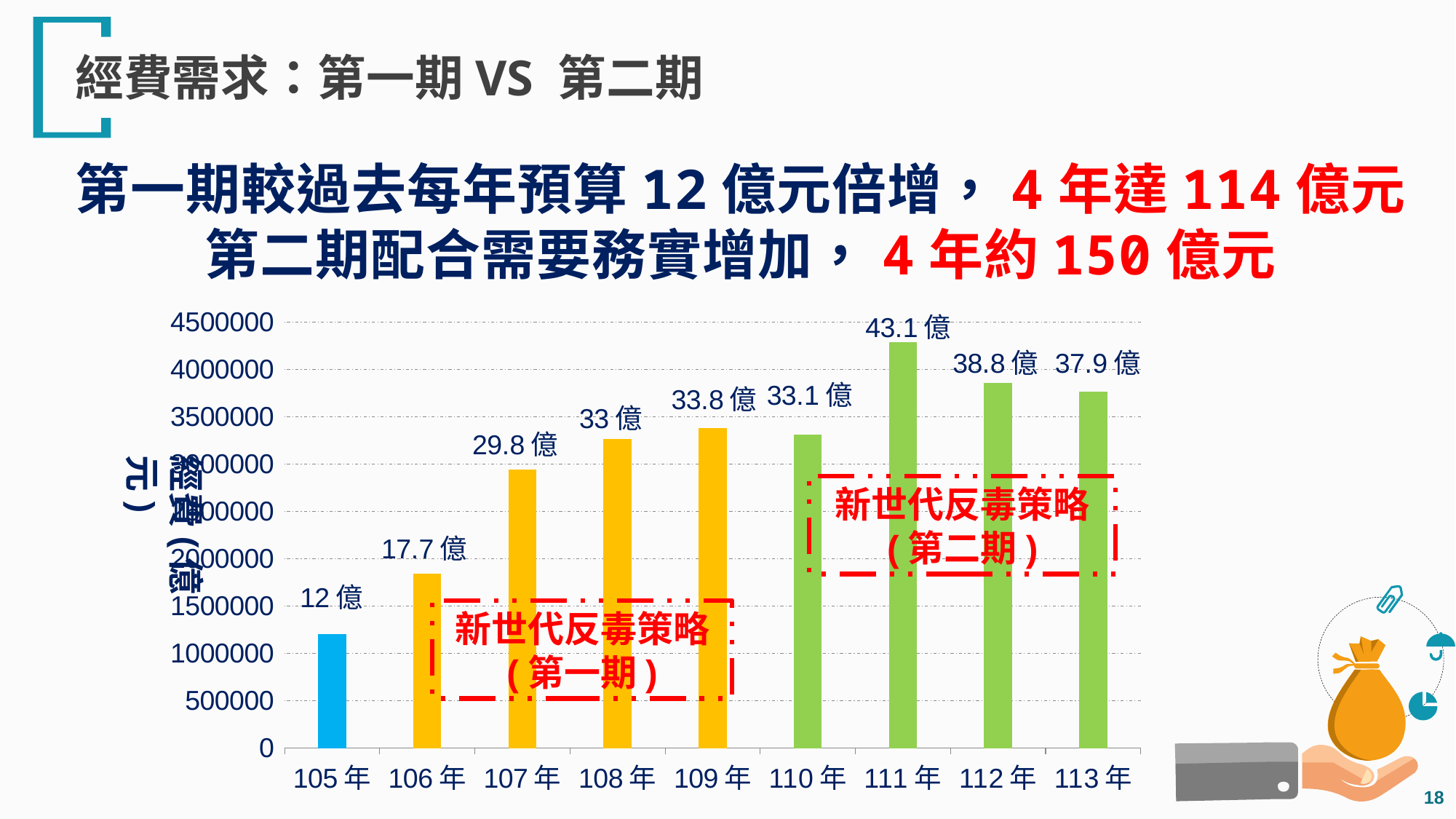
Do the values rise or fall from 105年 to 109年? rise Which is larger, the value for 107年 or the value for 112年? 112年 Which year has the highest value? 111年 What is the difference between the values for 111年 and 112年? 4.3 億 Which year has the lowest value? 105年 How many years are shown on the x axis? 9 What is the value shown for 105年? 12 億 What is the difference between the values for 106年 and 105年? 5.7 億 What is the value shown for 107年? 29.8 億 Is the value for 105年 greater or less than 1000000 on the axis? greater What is the value shown for 111年? 43.1 億 What kind of chart is shown on the slide? bar chart